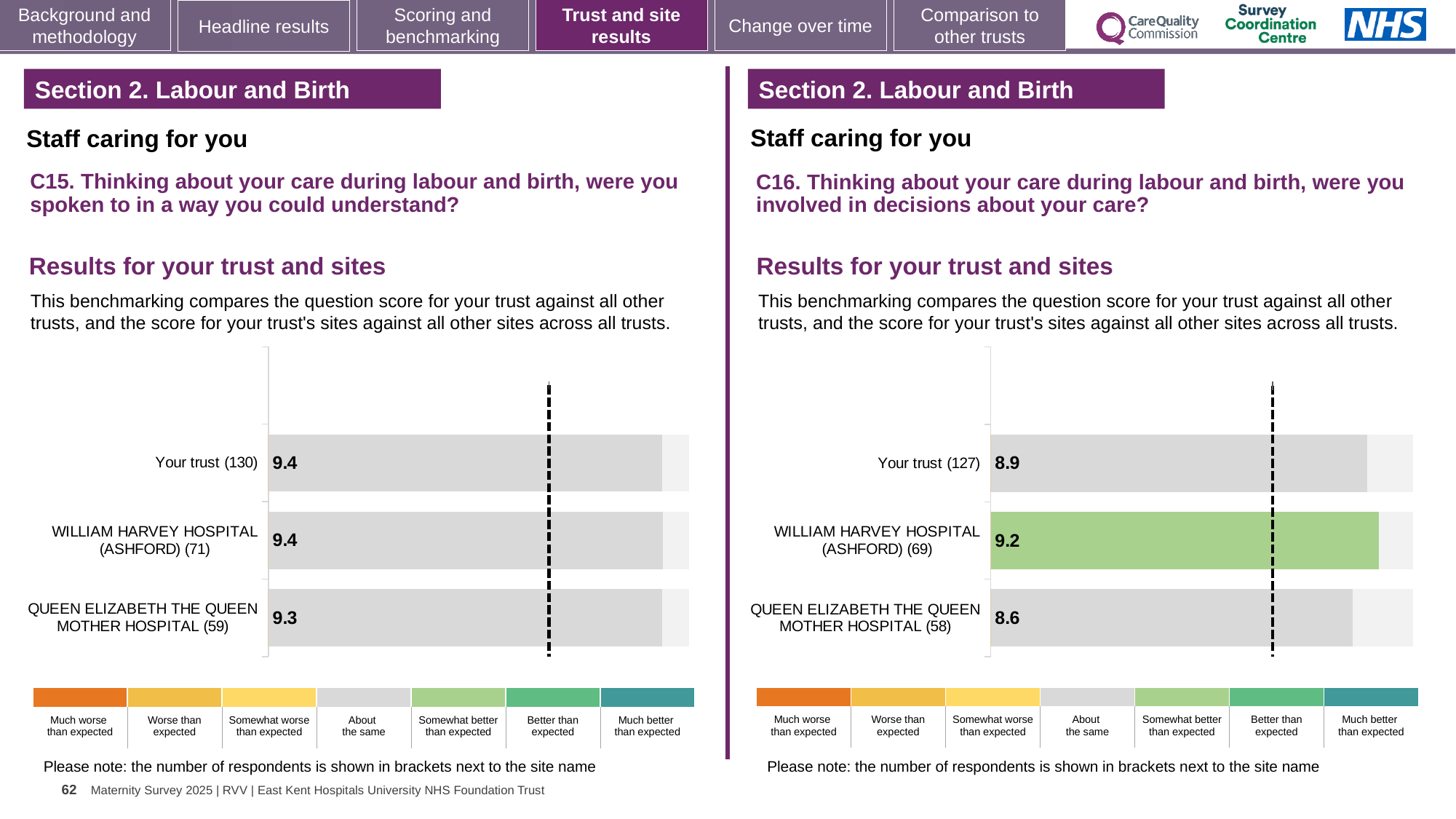
On the C16 chart (right), which has the larger score: Your trust or WILLIAM HARVEY HOSPITAL (ASHFORD)? WILLIAM HARVEY HOSPITAL (ASHFORD) On the C16 chart (right), which site or trust has the lowest score? QUEEN ELIZABETH THE QUEEN MOTHER HOSPITAL On the C16 chart (right), what is the score for WILLIAM HARVEY HOSPITAL (ASHFORD)? 9.2 On the C15 chart (left), what is the score for QUEEN ELIZABETH THE QUEEN MOTHER HOSPITAL? 9.3 On the C15 chart (left), what is the difference between the scores for Your trust and QUEEN ELIZABETH THE QUEEN MOTHER HOSPITAL? 0.1 On the C16 chart (right), how many respondents are shown in brackets for Your trust? 127 On the C16 chart (right), which site or trust has the highest score? WILLIAM HARVEY HOSPITAL (ASHFORD) On the C16 chart (right), what is the difference between the scores for WILLIAM HARVEY HOSPITAL (ASHFORD) and QUEEN ELIZABETH THE QUEEN MOTHER HOSPITAL? 0.6 On the C15 chart (left), what is the score for Your trust? 9.4 How many bars are shown on the C15 chart (left)? 3 What kind of chart is used on the C16 chart (right)? Bar chart On the C16 chart (right), what is the score for Your trust? 8.9